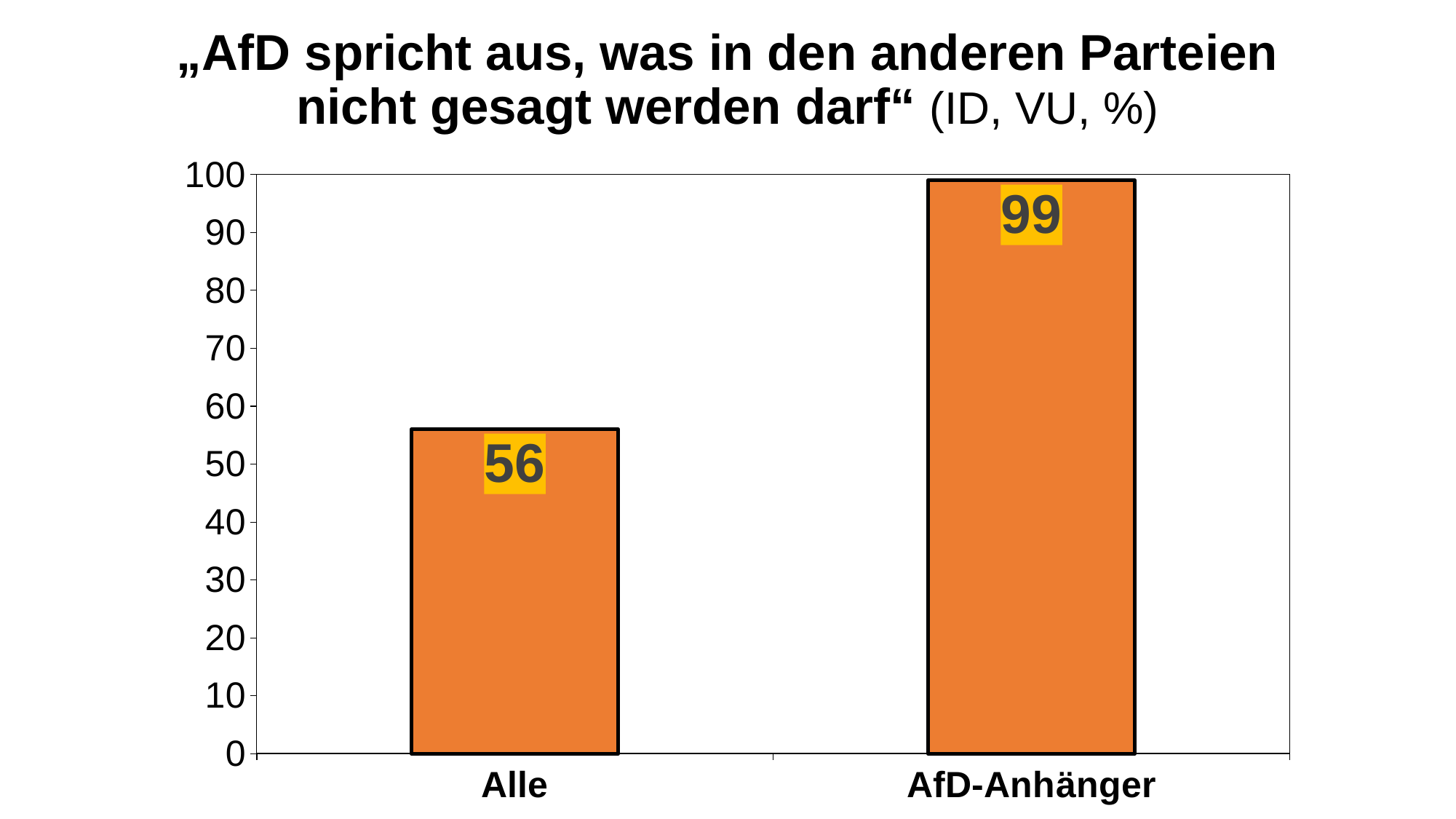
What kind of chart is shown on the slide? bar chart Is the value for Alle greater or less than 60? less Which is larger, the value for Alle or the value for AfD-Anhänger? AfD-Anhänger What is the value for AfD-Anhänger? 99 Which category has the highest value? AfD-Anhänger What is the value for Alle? 56 What is the difference between the values for AfD-Anhänger and Alle? 43 What colour are the bars in the chart? orange How many categories are shown on the x axis? 2 Is the value for AfD-Anhänger greater or less than 90? greater Which category has the lowest value? Alle What is the maximum value shown on the y axis? 100